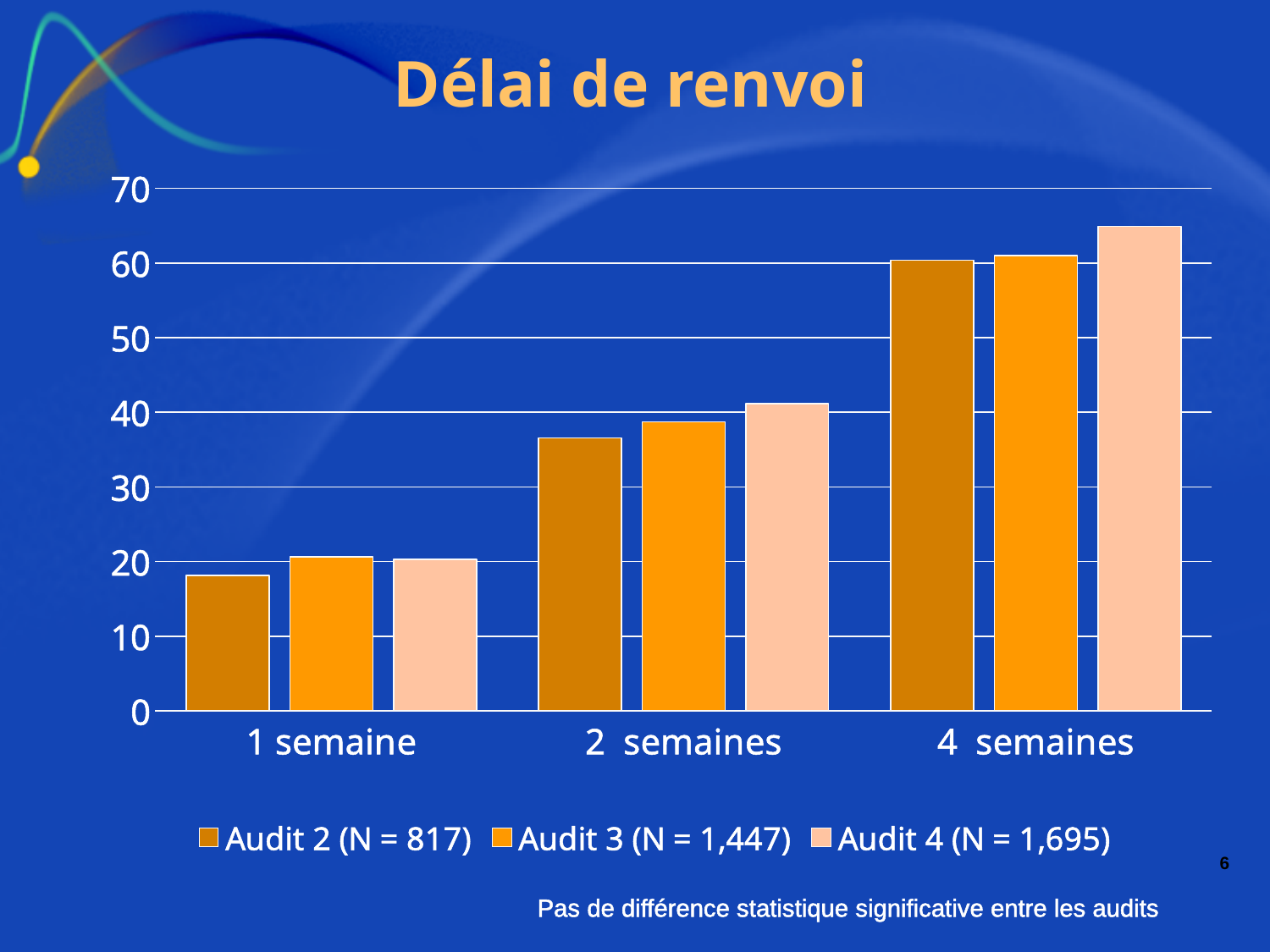
In the 2 semaines category, which is larger: the Audit 2 bar or the Audit 4 bar? Audit 4 Is the value for Audit 4 at 4 semaines greater or less than 60? greater Which series has the tallest bar in the 4 semaines category? Audit 4 (N = 1,695) How many categories are shown on the x axis? 3 How many series does the legend list? 3 Is the value for Audit 2 at 1 semaine greater or less than 20? less What kind of chart is shown on the slide? bar chart Which category has the highest bar for Audit 4? 4 semaines Do the values for Audit 3 rise or fall from 1 semaine to 4 semaines? rise Which category has the lowest bar for Audit 2? 1 semaine What is the title of the chart? Délai de renvoi What sample size (N) does the legend give for Audit 3? 1,447